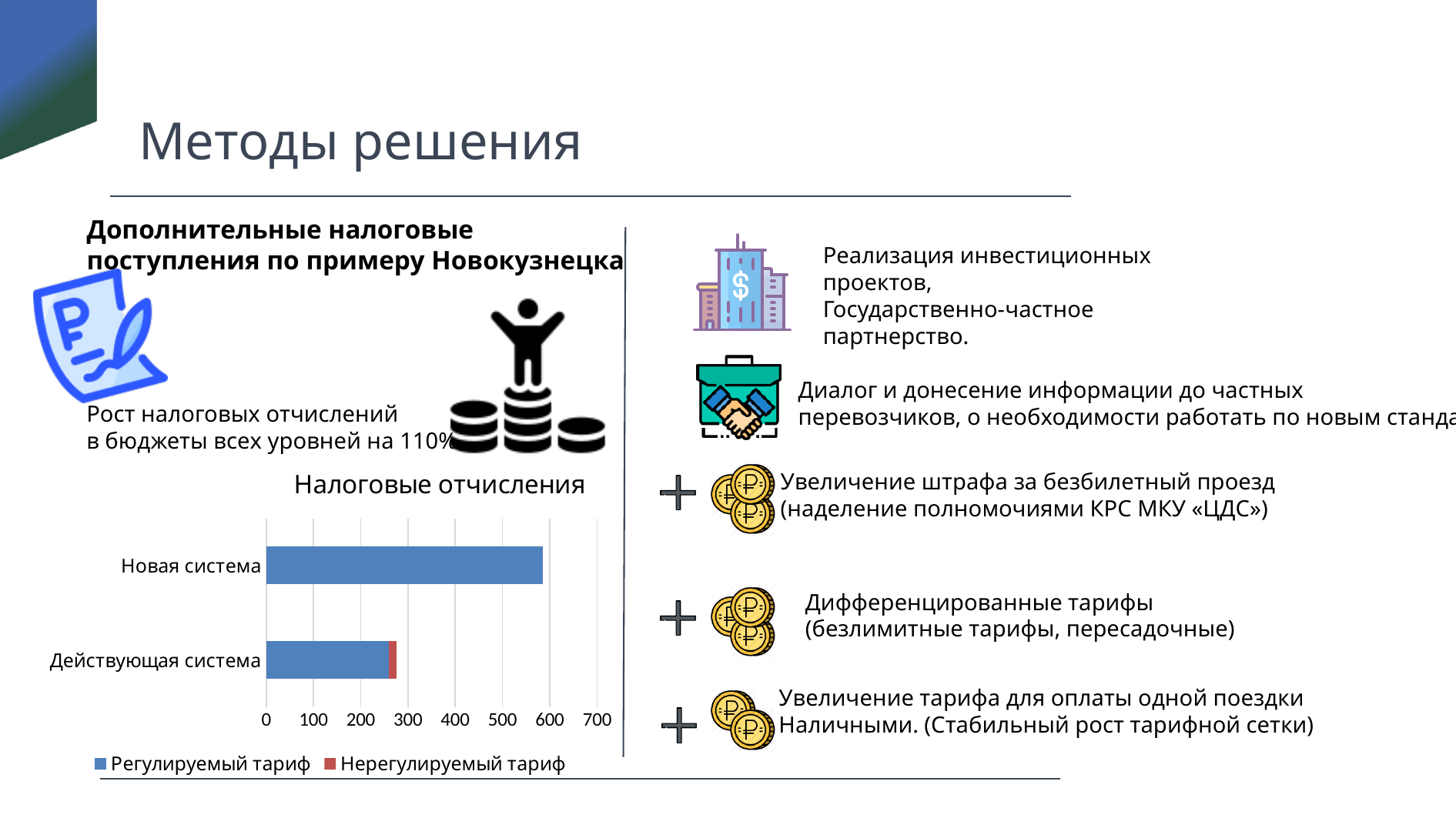
What type of chart is shown under the title "Налоговые отчисления"? bar chart Which series is shown in red in the chart "Налоговые отчисления"? Нерегулируемый тариф In the chart "Налоговые отчисления", is the total value for "Действующая система" greater or less than 300? less In the chart "Налоговые отчисления", which category includes a "Нерегулируемый тариф" segment? Действующая система How many categories are shown on the chart "Налоговые отчисления"? 2 What is the title of the chart on the slide? Налоговые отчисления What is the maximum value shown on the x axis of the chart "Налоговые отчисления"? 700 Which category has the shortest bar in the chart "Налоговые отчисления"? Действующая система In the chart "Налоговые отчисления", is the value for "Новая система" greater or less than 500? greater How many series does the legend of the chart "Налоговые отчисления" list? 2 In the chart "Налоговые отчисления", is the "Регулируемый тариф" value for "Новая система" larger or smaller than that for "Действующая система"? larger Which category has the longest bar in the chart "Налоговые отчисления"? Новая система